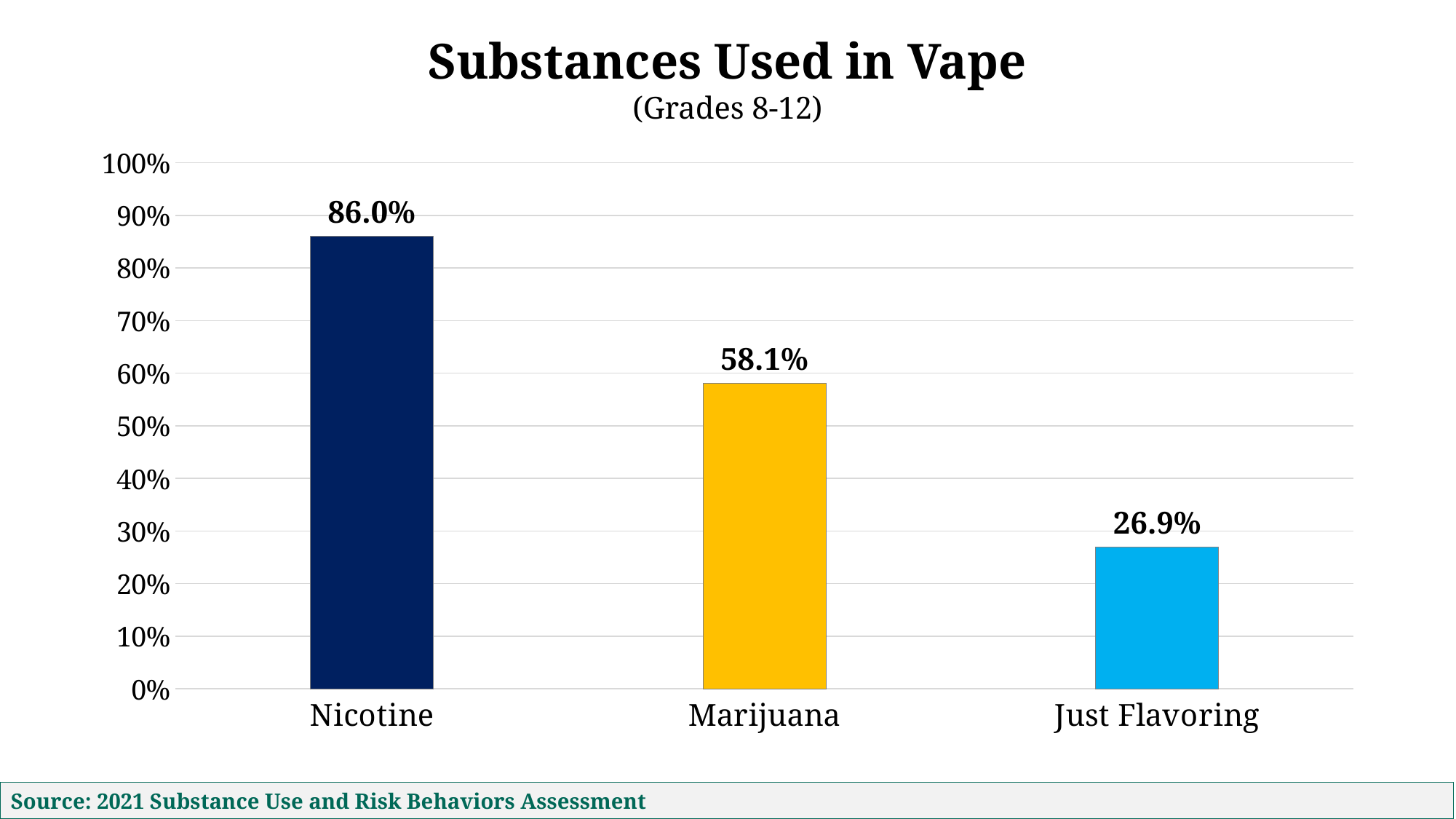
Which substance has the lowest value? Just Flavoring Which is larger, the value for Marijuana or the value for Just Flavoring? Marijuana What is the difference between the values for Nicotine and Marijuana? 27.9% Which substance has the highest value? Nicotine What is the value for Nicotine? 86.0% What is the value for Just Flavoring? 26.9% What is the difference between the values for Marijuana and Just Flavoring? 31.2% What is the value for Marijuana? 58.1% Is the value for Just Flavoring greater or less than 30%? less How many substance categories are shown in the chart? 3 What kind of chart is shown on the slide? Bar chart What is the title of the chart? Substances Used in Vape